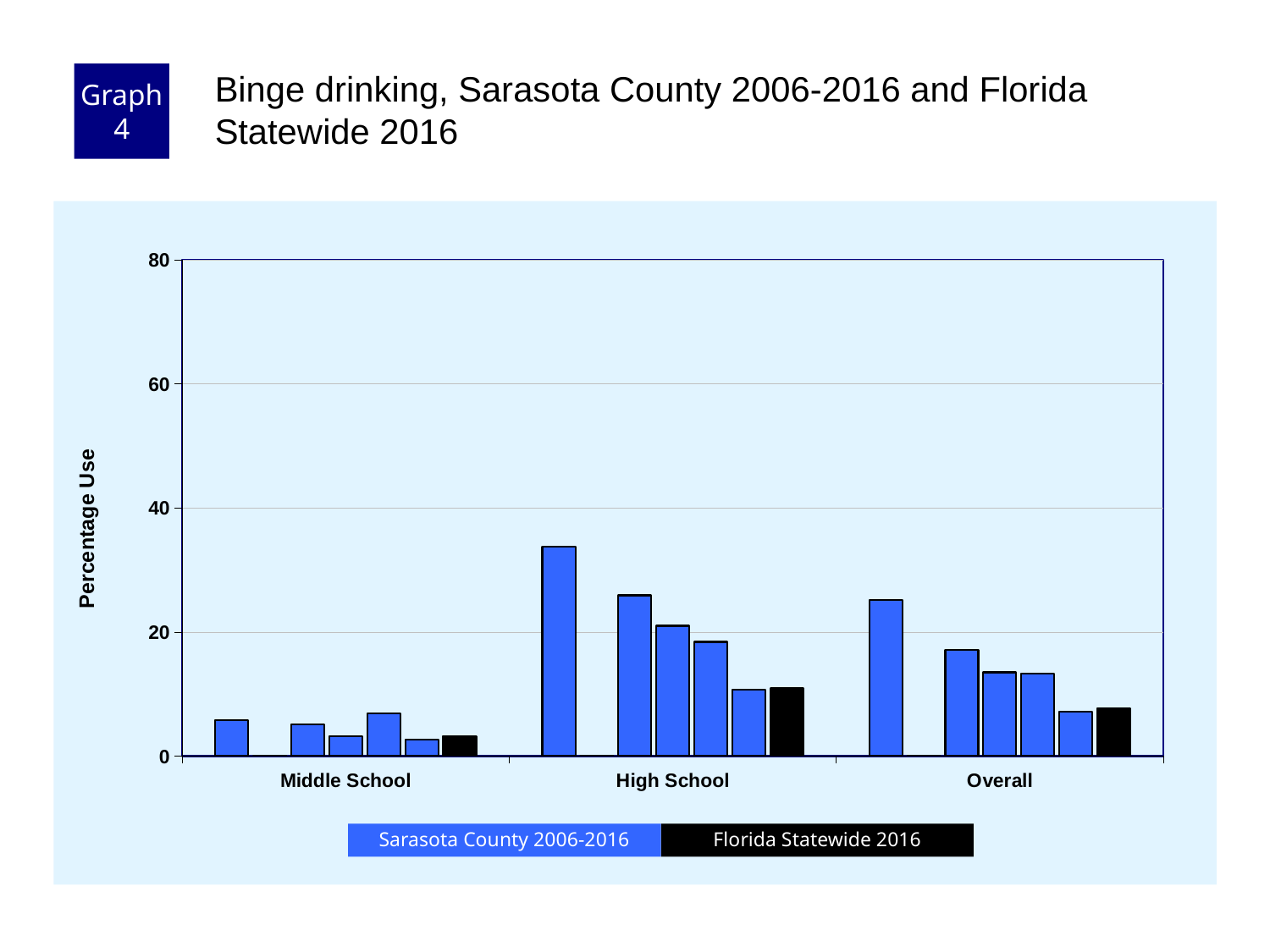
Which category contains the lowest bars overall? Middle School Is the Florida Statewide 2016 value for High School greater or less than 20? less How many categories are shown on the x axis? 3 What kind of chart is shown on the slide? bar chart What is the title of the chart? Binge drinking, Sarasota County 2006-2016 and Florida Statewide 2016 Which is larger, the Florida Statewide 2016 value for High School or for Middle School? High School Is the tallest Sarasota County bar for High School greater or less than 20? greater What is the label on the y axis? Percentage Use Within the High School category, do the Sarasota County 2006-2016 bars rise or fall from left to right? fall Is the tallest Sarasota County bar for Middle School greater or less than 20? less How many series does the legend list? 2 Which category contains the tallest bar? High School